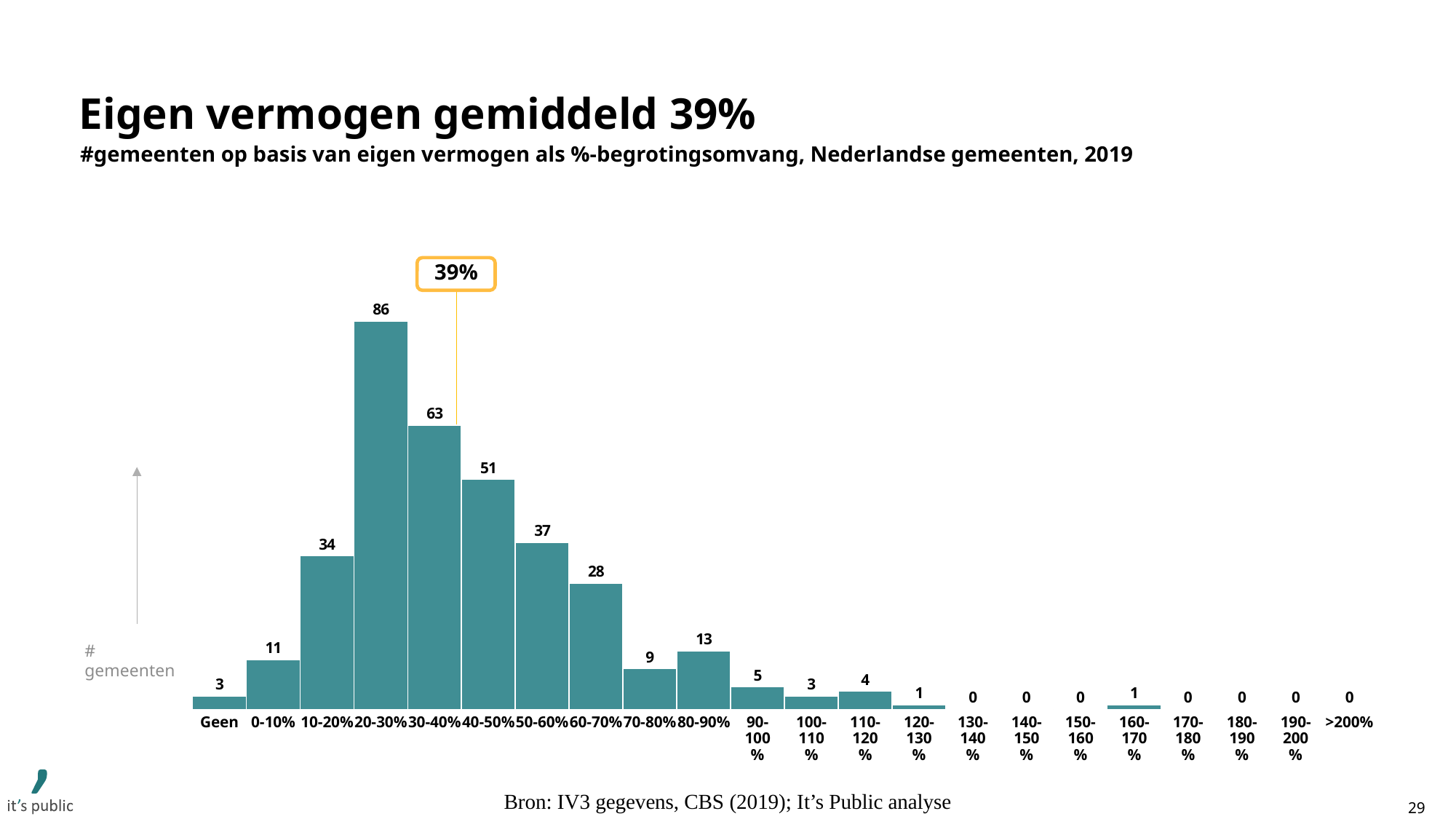
How many municipalities are in the 20-30% category? 86 Which category has the highest number of municipalities? 20-30% What is the difference between the 40-50% and 50-60% categories? 14 How many categories are shown on the x axis? 22 Which is larger, the value for 0-10% or the value for 10-20%? 10-20% What is the value shown for the 160-170% category? 1 What is the value for the 'Geen' category? 3 How many municipalities fall in the 80-90% category? 13 What kind of chart is shown on the slide? Bar chart What average value is highlighted in the callout box above the chart? 39% What is the difference between the 20-30% and 30-40% categories? 23 Which is larger, the value for 70-80% or the value for 80-90%? 80-90%